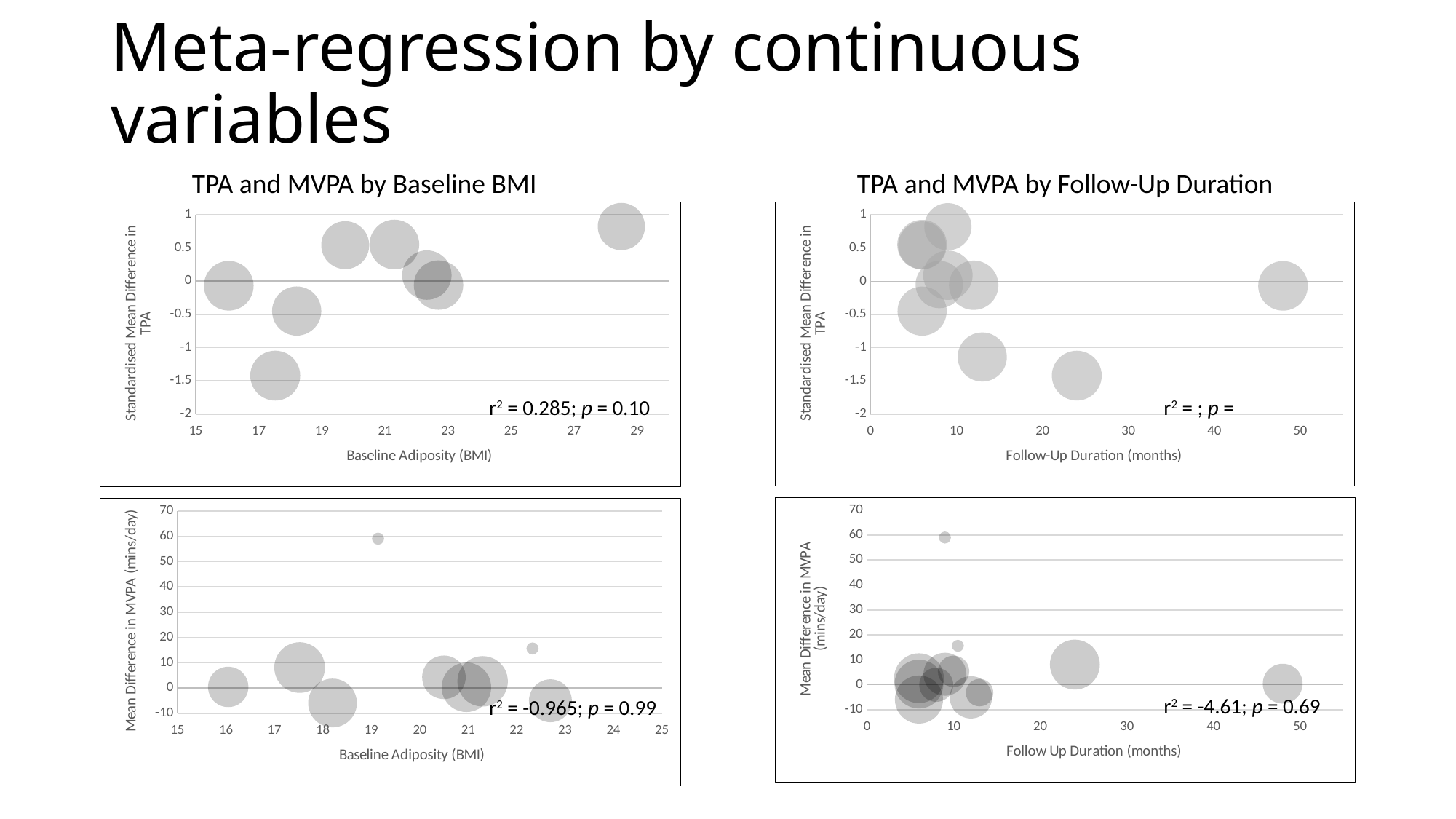
In the top-left chart (TPA by Baseline BMI), what r² value is printed on the chart? 0.285 In the top-left chart (TPA by Baseline BMI), what p value is printed on the chart? 0.10 In the bottom-right chart (MVPA by Follow Up Duration), what p value is printed on the chart? 0.69 In the bottom-right chart (MVPA by Follow Up Duration), is the mean difference in MVPA for the bubble near 48 months greater or less than 20? less In the top-right chart (TPA by Follow-Up Duration), what is the x-axis title? Follow-Up Duration (months) In the top-left chart (TPA by Baseline BMI), is the standardised mean difference for the bubble near BMI 28.5 greater or less than 0.5? greater What kind of chart is the top-left chart titled 'TPA and MVPA by Baseline BMI'? bubble chart In the bottom-left chart (MVPA by Baseline BMI), is the mean difference in MVPA for the small point near BMI 19 greater or less than 50? greater In the top-left chart (TPA by Baseline BMI), what is the x-axis title? Baseline Adiposity (BMI) In the bottom-left chart (MVPA by Baseline BMI), what r² value is printed on the chart? -0.965